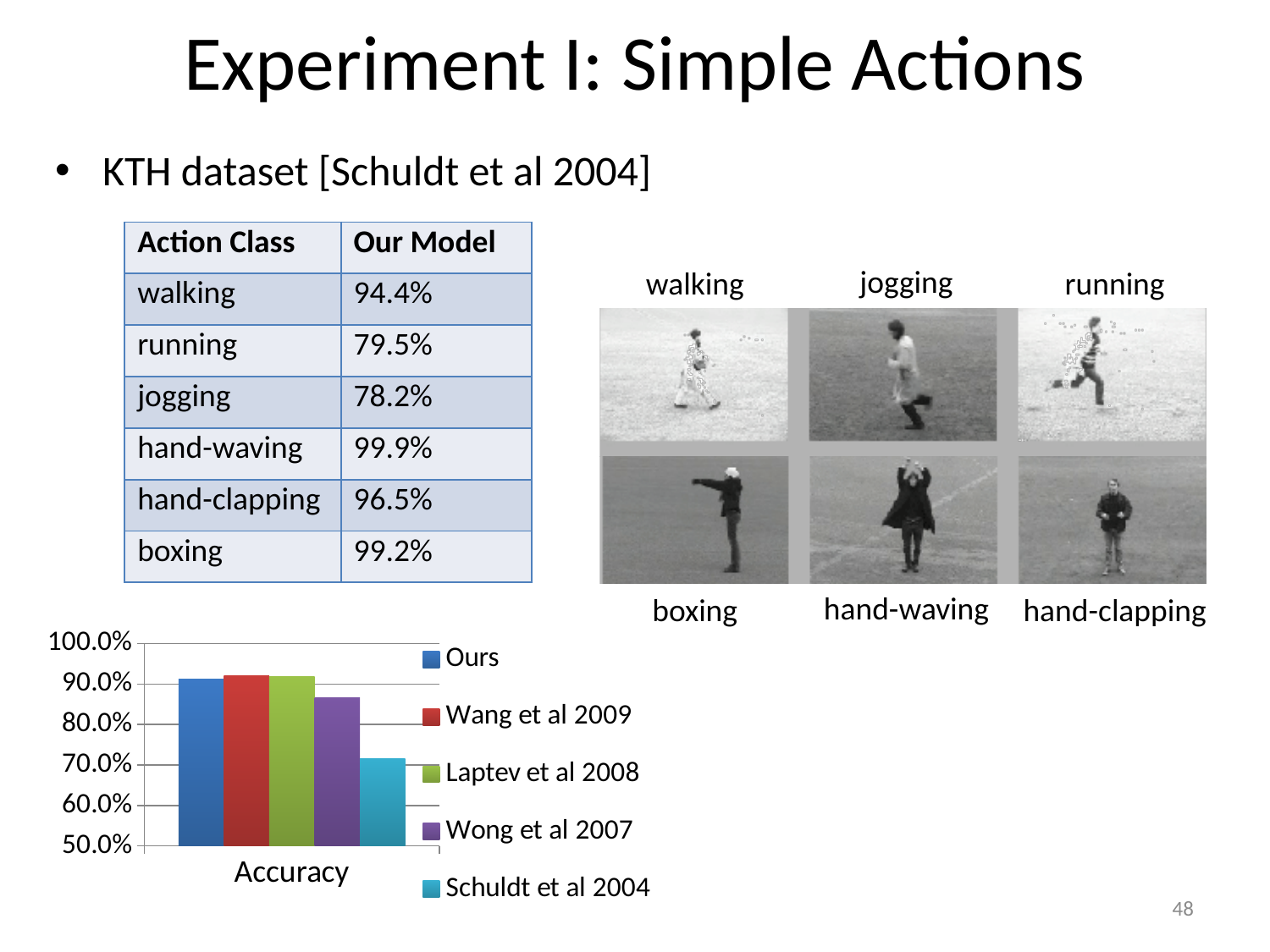
In the bar chart, is the accuracy for Wong et al 2007 greater or less than 80%? greater What kind of chart is shown at the bottom left of the slide? bar chart What is the category label on the x axis of the bar chart? Accuracy How many categories are shown on the x axis of the Accuracy chart? 1 In the bar chart, is the accuracy for Wong et al 2007 greater or less than 90%? less In the bar chart, is the accuracy for Schuldt et al 2004 greater or less than 80%? less Which series is listed first in the legend of the bar chart? Ours How many series does the legend of the Accuracy chart list? 5 Which series has the lowest accuracy in the bar chart? Schuldt et al 2004 In the bar chart, which has the higher accuracy: Wong et al 2007 or Schuldt et al 2004? Wong et al 2007 In the bar chart, which has the higher accuracy: Ours or Wong et al 2007? Ours